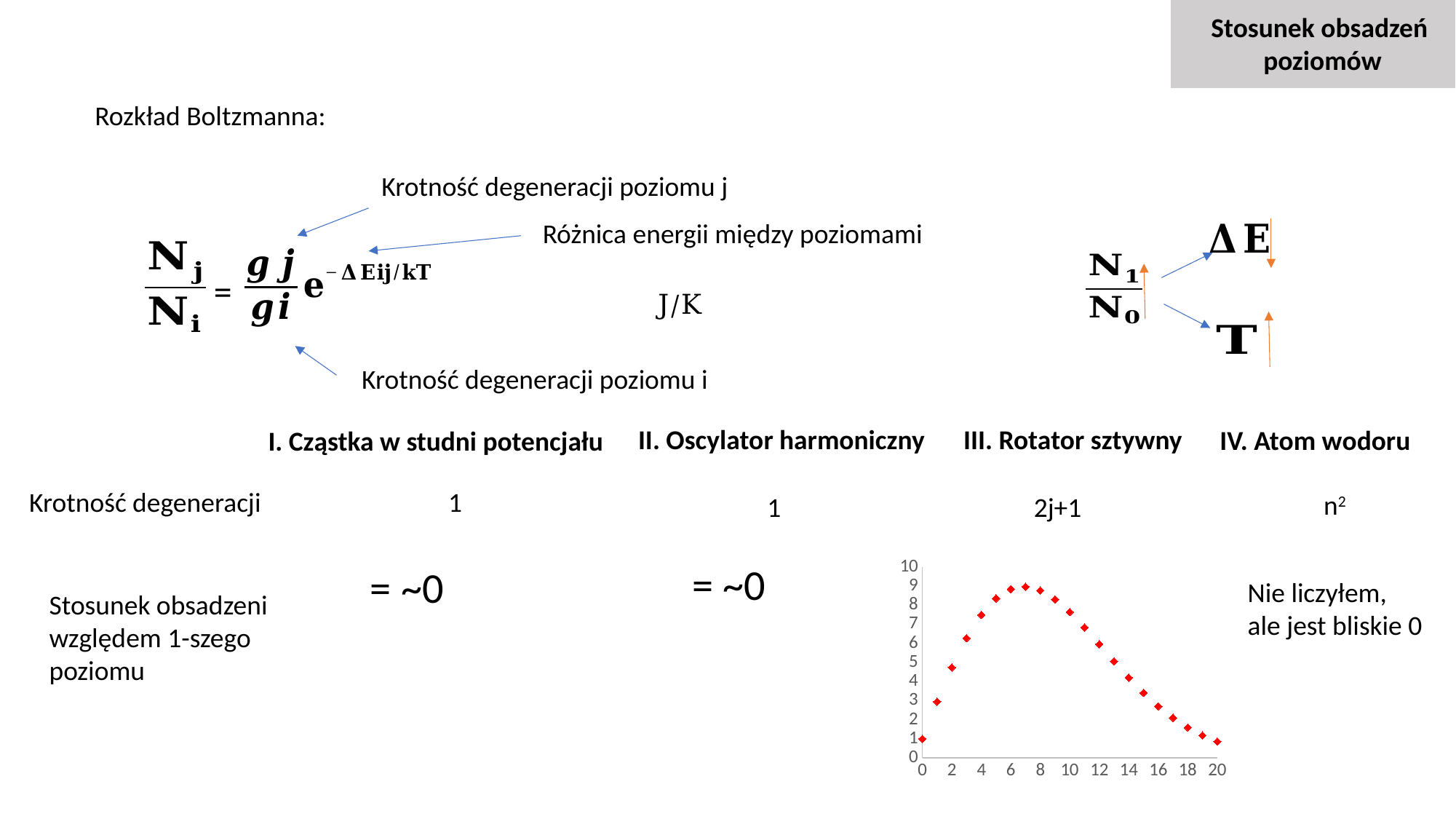
In the scatter chart, is the value at x = 7 greater or less than 8? greater In the scatter chart, is the value at x = 16 greater or less than 4? less What kind of chart is shown at the bottom of the slide? scatter chart What colour are the markers in the scatter chart? red In the scatter chart, which has the larger value: the point at x = 4 or the point at x = 16? x = 4 What is the highest value shown on the y axis of the scatter chart? 10 In the scatter chart, is the value at x = 0 greater or less than 2? less How many data points are plotted in the scatter chart? 21 In the scatter chart, which has the larger value: the point at x = 12 or the point at x = 18? x = 12 How do the values in the scatter chart change as x increases from 0 to 20? they rise, then fall